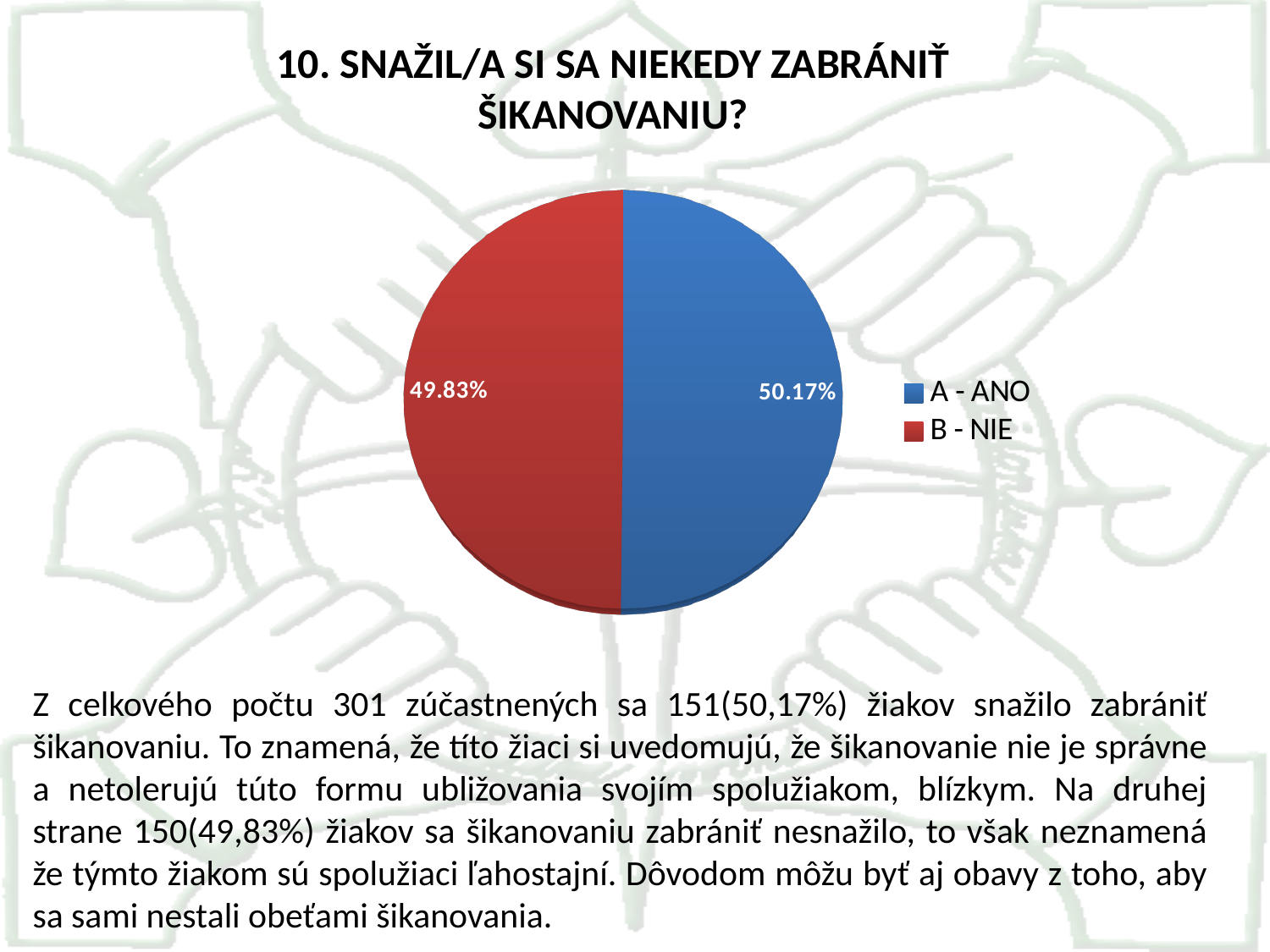
What share of the pie does the slice "B - NIE" represent? 49.83% According to the data labels, which is larger: "A - ANO" or "B - NIE"? A - ANO What is the difference in percentage points between the "A - ANO" and "B - NIE" slices? 0.34% Which slice of the pie chart is the largest? A - ANO Which slice of the pie chart is the smallest? B - NIE How many slices does the pie chart have? 2 What share of the pie does the slice "A - ANO" represent? 50.17% How many entries does the legend of the pie chart list? 2 What colour is the "B - NIE" slice in the pie chart? red What kind of chart is shown on the slide? pie chart What is the value labelled on the red slice of the pie chart? 49.83% What is the value labelled on the blue slice of the pie chart? 50.17%